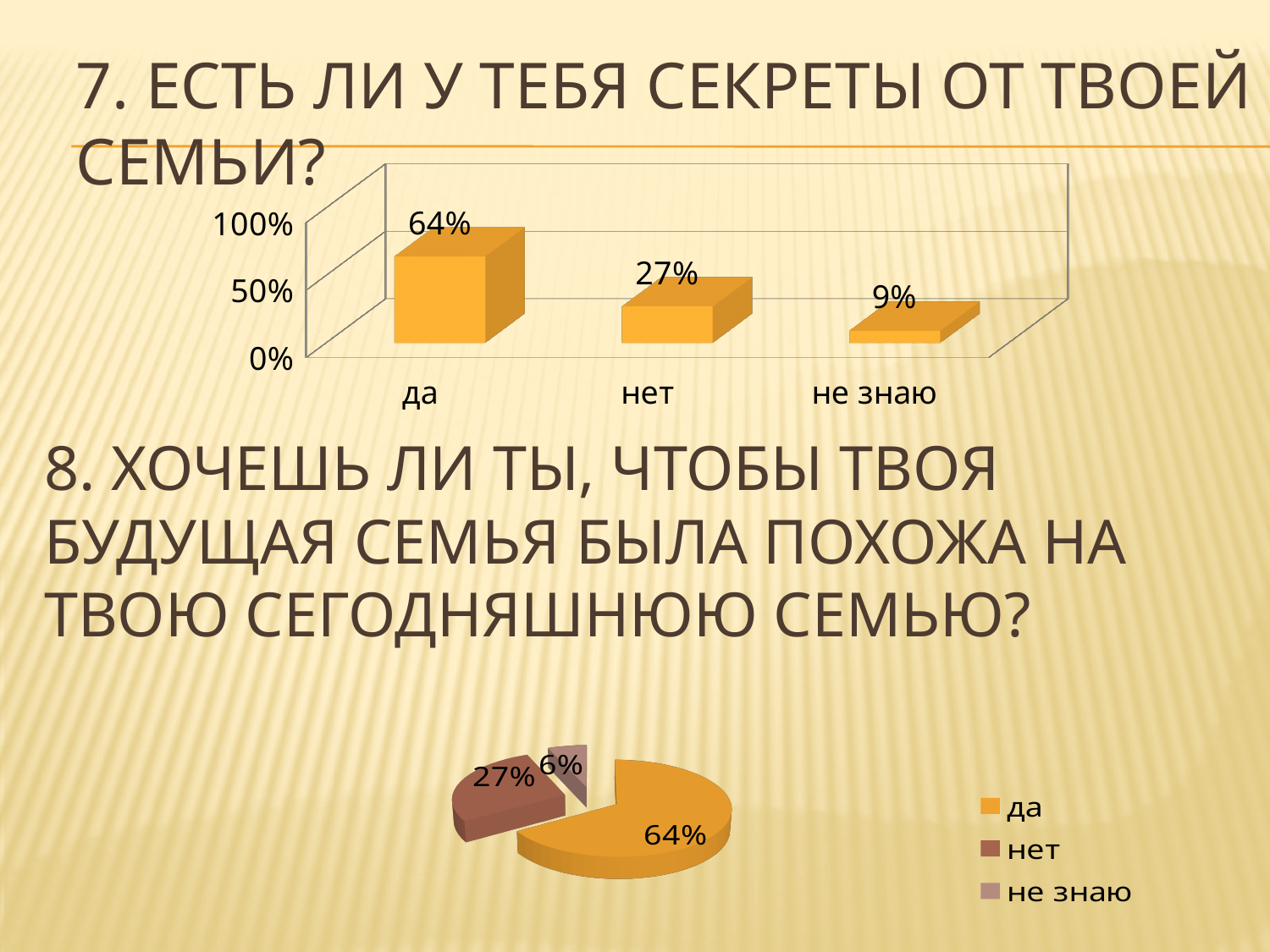
In the top bar chart, what is the value for "да"? 64% In the bottom pie chart, which slice is the largest? да In the bottom pie chart, what is the share for "не знаю"? 6% In the top bar chart, what is the value for "не знаю"? 9% How many entries does the legend of the bottom pie chart list? 3 In the top bar chart, is the value for "нет" greater or less than 50%? less What kind of chart is the bottom chart on the slide? pie chart In the bottom pie chart, what is the share for "нет"? 27% In the top bar chart, which category has the lowest value? не знаю In the top bar chart, what is the difference between the values for "да" and "нет"? 37% What kind of chart is the top chart on the slide? bar chart How many categories are shown in the top bar chart? 3